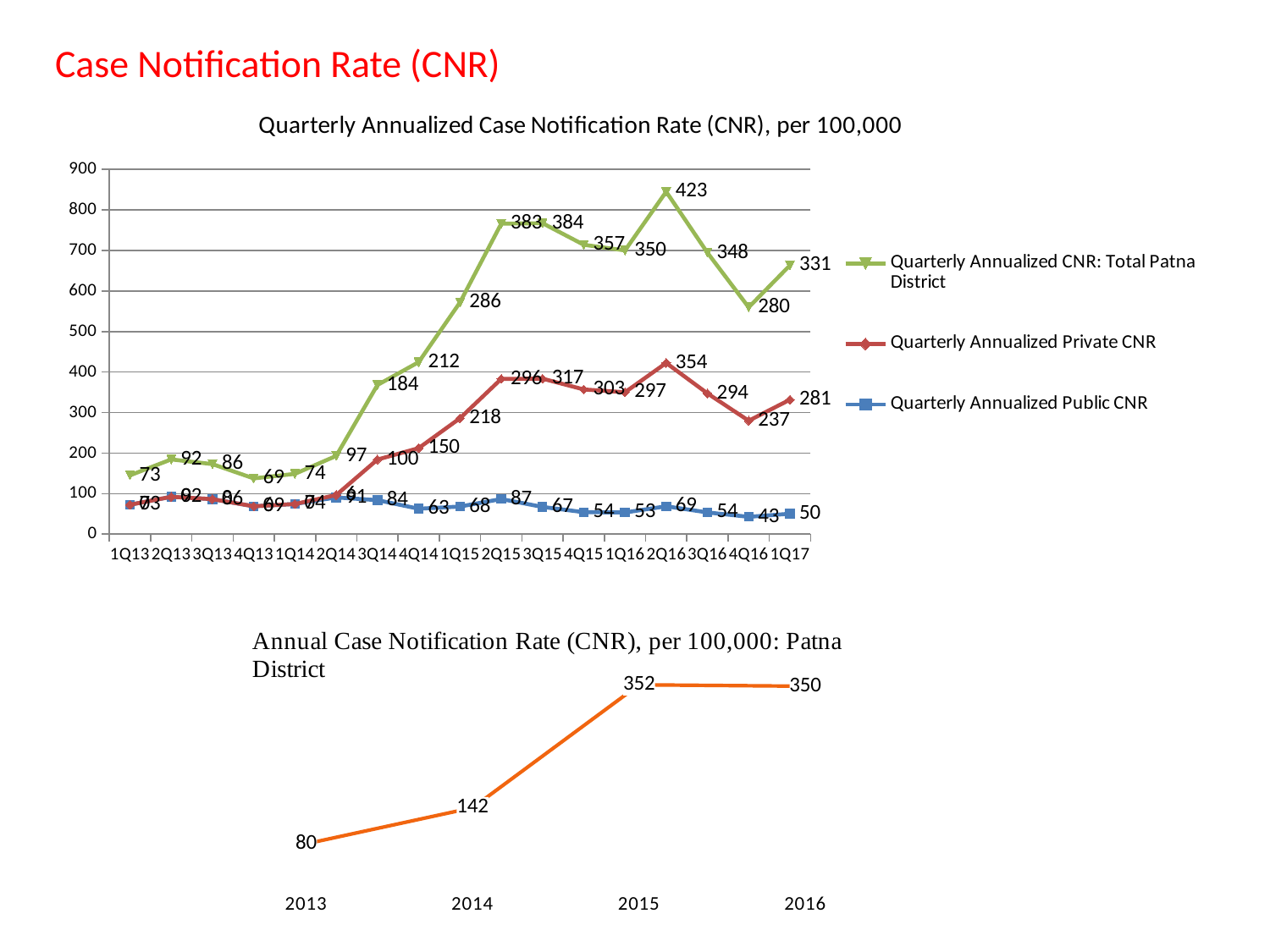
In the bottom chart (Annual Case Notification Rate, Patna District), what is the difference between the 2015 and 2013 values? 272 In the top chart (Quarterly Annualized CNR), how much higher is the Total Patna District value in 1Q17 than in 4Q16? 51 How many series does the legend of the top chart (Quarterly Annualized CNR) list? 3 In the bottom chart (Annual Case Notification Rate, Patna District), which year has the highest value? 2015 In the top chart (Quarterly Annualized CNR), what is the Total Patna District value for 2Q16? 423 In the bottom chart (Annual Case Notification Rate, Patna District), what is the value for 2014? 142 In the top chart (Quarterly Annualized CNR), what is the Public CNR value for 4Q16? 43 What kind of chart is the bottom chart (Annual Case Notification Rate, Patna District)? Line chart In the top chart (Quarterly Annualized CNR), is the Private CNR higher in 2Q16 or 3Q16? 2Q16 How many years are plotted in the bottom chart (Annual Case Notification Rate, Patna District)? 4 In the top chart (Quarterly Annualized CNR), what is the Private CNR value for 1Q17? 281 In the top chart (Quarterly Annualized CNR), in which quarter does the Total Patna District series reach its highest value? 2Q16